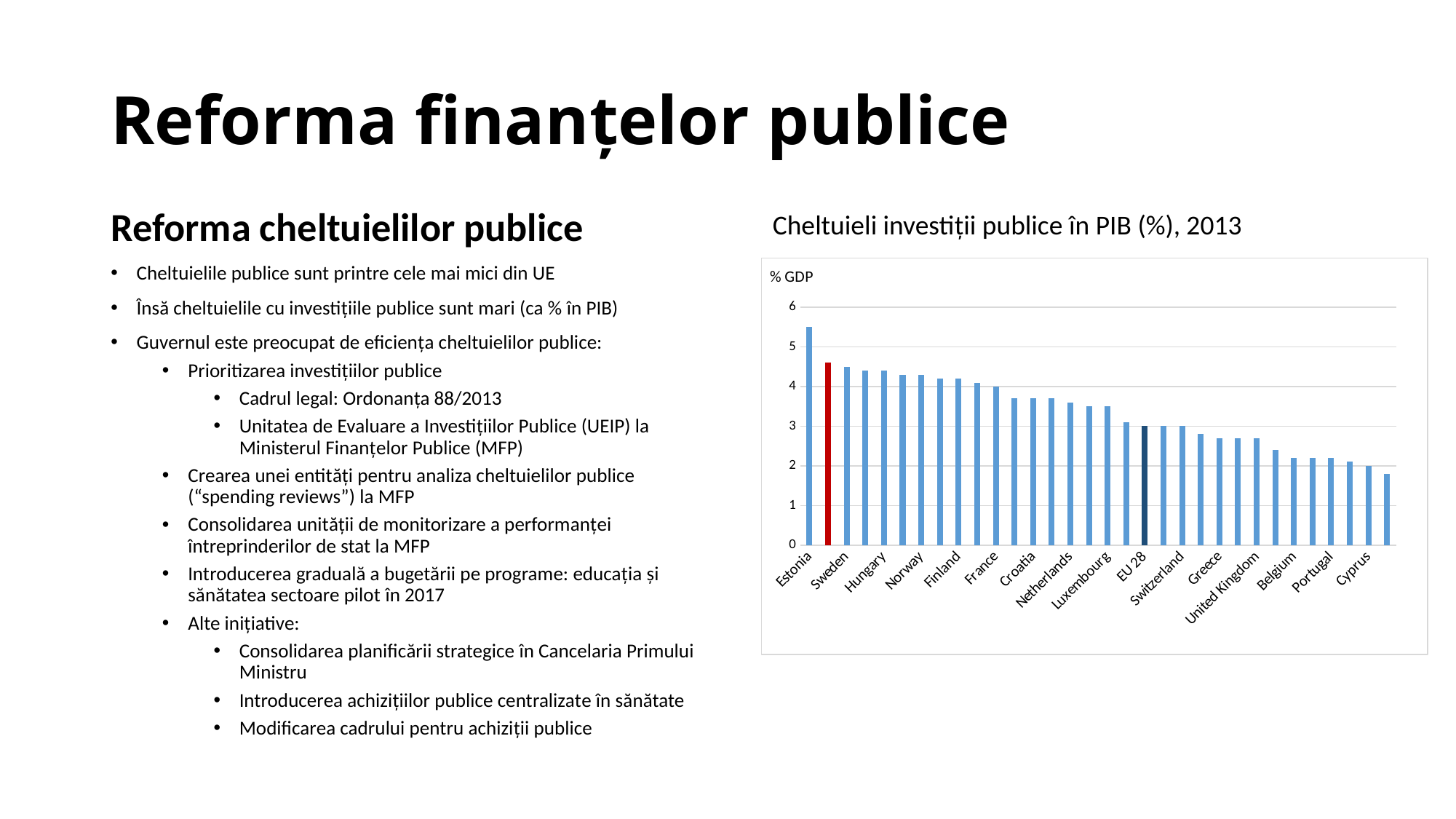
Is the value for Estonia greater or less than 5? greater What is the title of the chart? Cheltuieli investiții publice în PIB (%), 2013 Which is larger, the value for Estonia or the value for EU 28? Estonia Is the value for France greater or less than 3? greater What kind of chart is shown on the slide? bar chart Do the values rise or fall moving from left to right along the x axis? fall Is the value for Greece greater or less than 3? less What label is shown on the vertical axis of the chart? % GDP Which country has the highest public investment share in the chart? Estonia